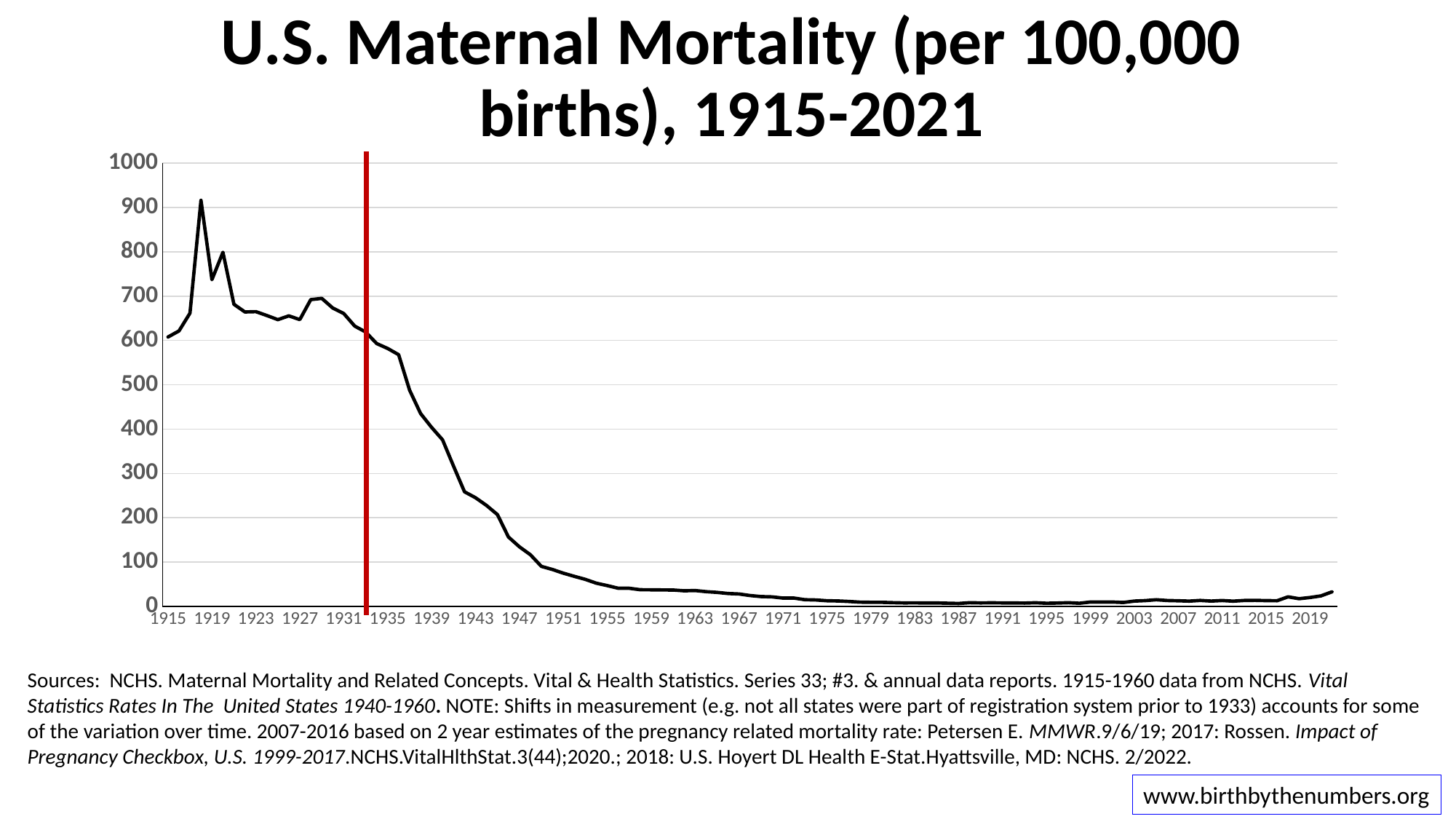
Is the value for 2019 greater or less than 100? less Which year has the larger value, 1915 or 2019? 1915 Is the value for 1939 greater or less than 300? greater Is the value for 1947 greater or less than 200? less Overall, do the values rise or fall from 1915 to 2019 along the x axis? Fall What is the highest value shown on the y axis? 1000 What is the title of the chart? U.S. Maternal Mortality (per 100,000 births), 1915-2021 What kind of chart is shown on the slide? Line chart Which year has the larger value, 1935 or 1951? 1935